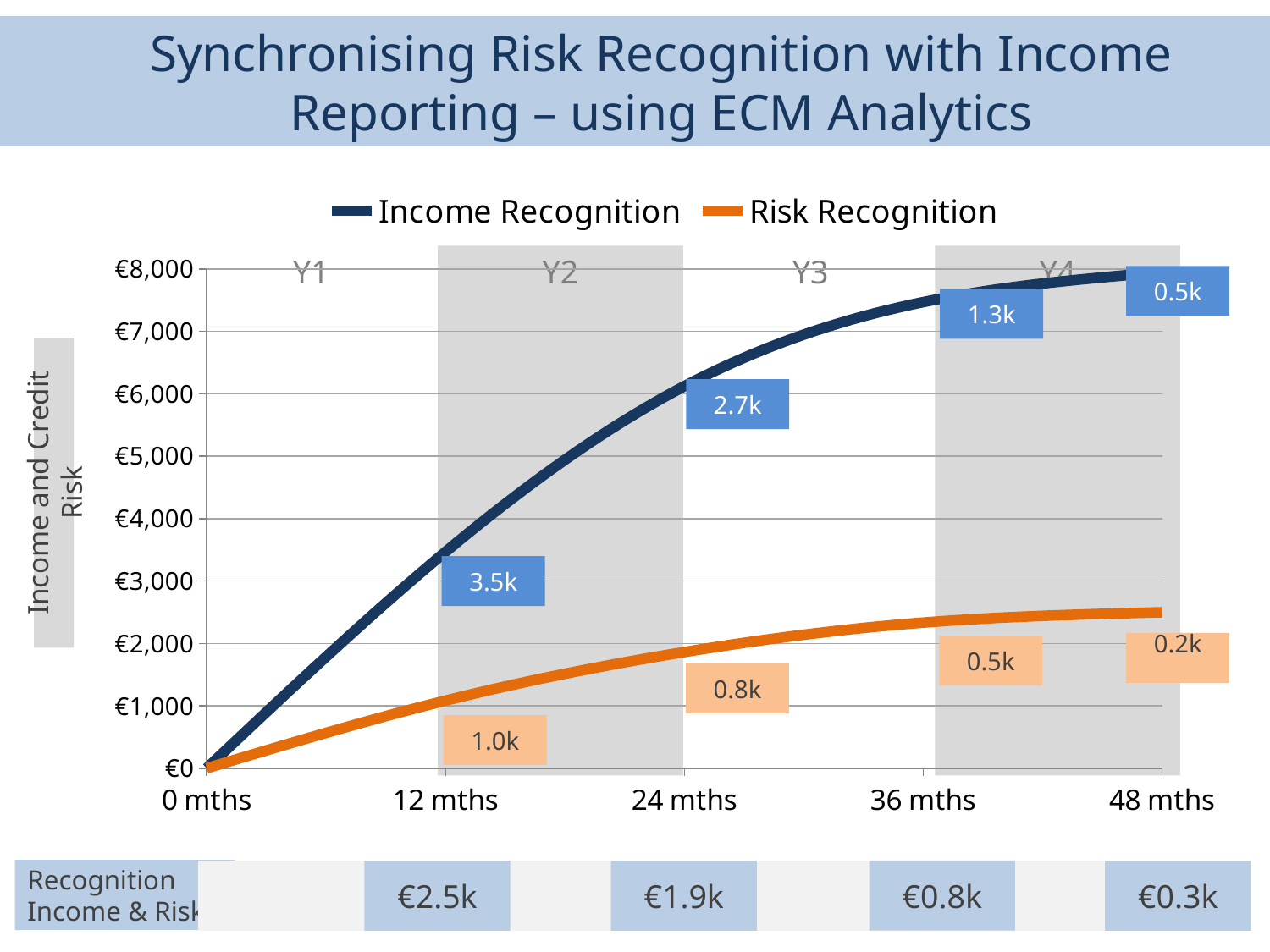
Is the Income Recognition value at 48 mths greater or less than €7,000? greater How many series does the legend list? 2 At 36 mths, which series has the higher value, Income Recognition or Risk Recognition? Income Recognition Is the Income Recognition value at 12 mths greater or less than €3,000? greater What label is shown in the blue box for Income Recognition in the Y2 band? 3.5k Is the Income Recognition value at 24 mths greater or less than €5,000? greater What kind of chart is shown on the slide? line chart Does the Income Recognition line rise or fall from 0 mths to 48 mths? rise How many labelled points are on the x axis? 5 What are the two series named in the legend? Income Recognition and Risk Recognition